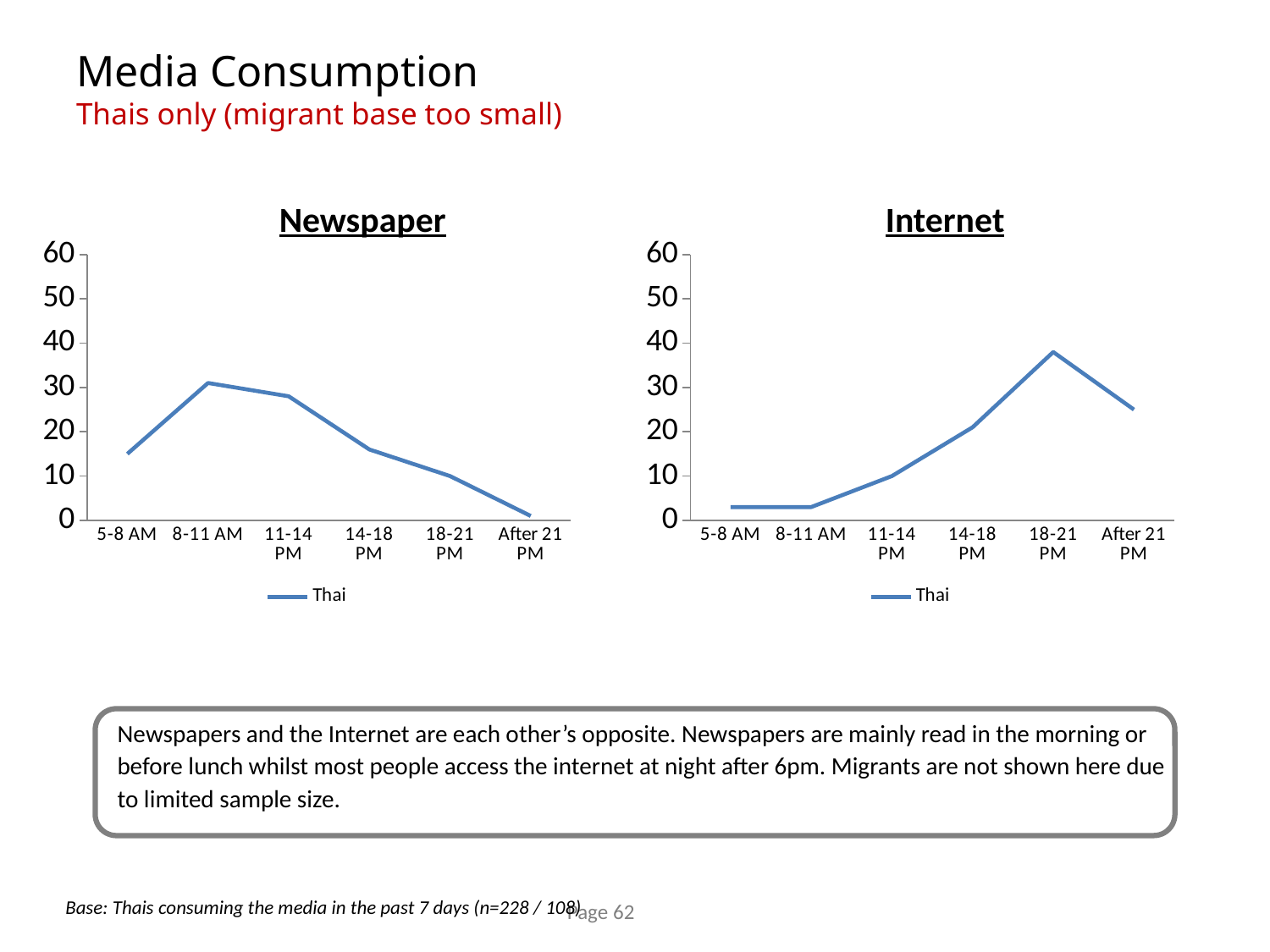
How many series does the legend of the Newspaper chart list? 1 In the Newspaper chart, is the value for 5-8 AM greater or less than 20? less In the Internet chart, which is larger, the value for 11-14 PM or the value for 18-21 PM? 18-21 PM In the Newspaper chart, is the value for After 21 PM greater or less than 10? less In the Internet chart, which time slot has the highest value? 18-21 PM In the Internet chart, is the value for 5-8 AM greater or less than 10? less What kind of chart is the Newspaper chart? line chart In the Newspaper chart, which time slot has the highest value? 8-11 AM How many time slots are shown on the x axis of the Internet chart? 6 In the Newspaper chart, which time slot has the lowest value? After 21 PM In the Internet chart, do the values rise or fall from 5-8 AM to 18-21 PM? rise